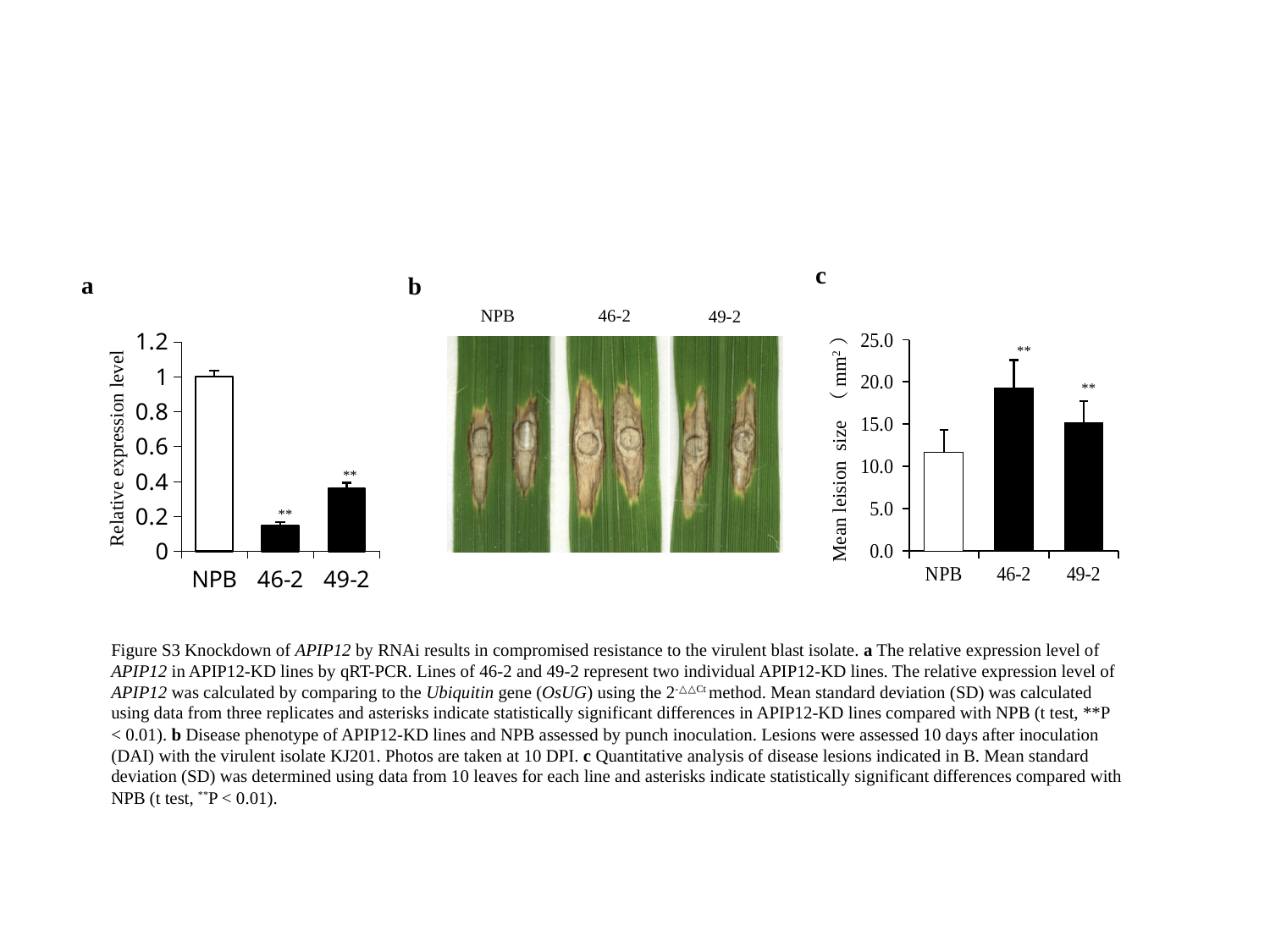
In chart a (Relative expression level), which category has the highest value? NPB In chart a (Relative expression level), what kind of chart is shown? bar chart In chart c (Mean lesion size), which category has the highest value? 46-2 In chart c (Mean lesion size), is the value for 46-2 greater or less than 15.0? greater In chart a (Relative expression level), how many categories are plotted on the x axis? 3 In chart c (Mean lesion size), which category has the lowest value? NPB In chart a (Relative expression level), is the value for 49-2 greater or less than 0.4? less In chart a (Relative expression level), which category has the lowest value? 46-2 In chart c (Mean lesion size), is the value for NPB greater or less than 15.0? less In chart a (Relative expression level), which has the larger value, 46-2 or 49-2? 49-2 In chart c, what is the label of the y axis? Mean lesion size (mm²) In chart a (Relative expression level), what is the relative expression level for NPB? 1